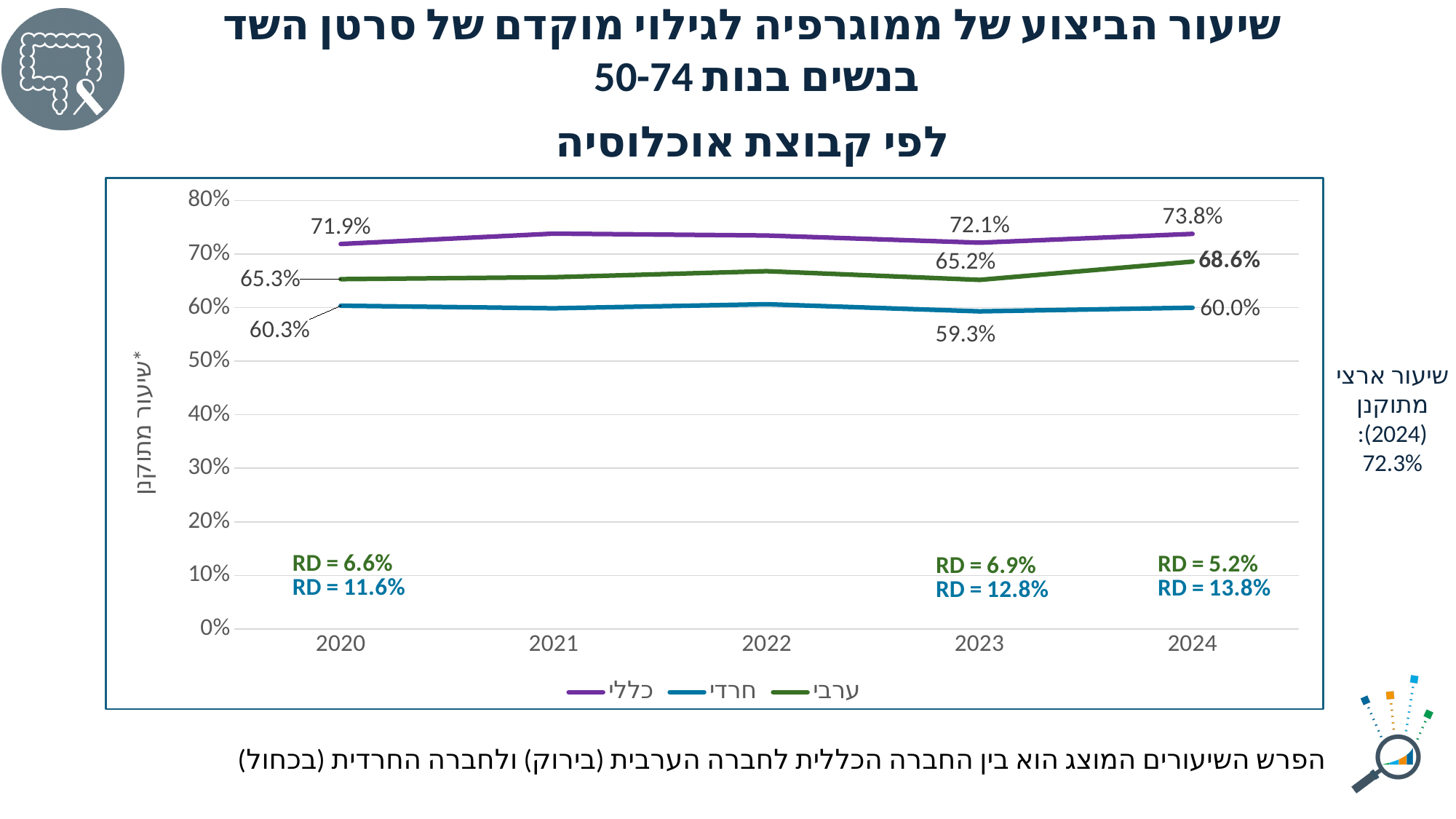
What is the value for the ערבי series in 2020? 65.3% Which series has the lowest value in 2024? חרדי How many series does the legend list? 3 What is the value for the כללי series in 2024? 73.8% Is the value for the ערבי series in 2022 greater or less than 60%? greater Which is larger, the ערבי value in 2023 or the ערבי value in 2024? 2024 How many years are shown on the x axis? 5 Which series has the highest value in 2020? כללי What is the value for the חרדי series in 2023? 59.3% What is the difference between the כללי and ערבי values in 2024? 5.2% What type of chart is shown on the slide? line chart What is the value for the חרדי series in 2024? 60.0%